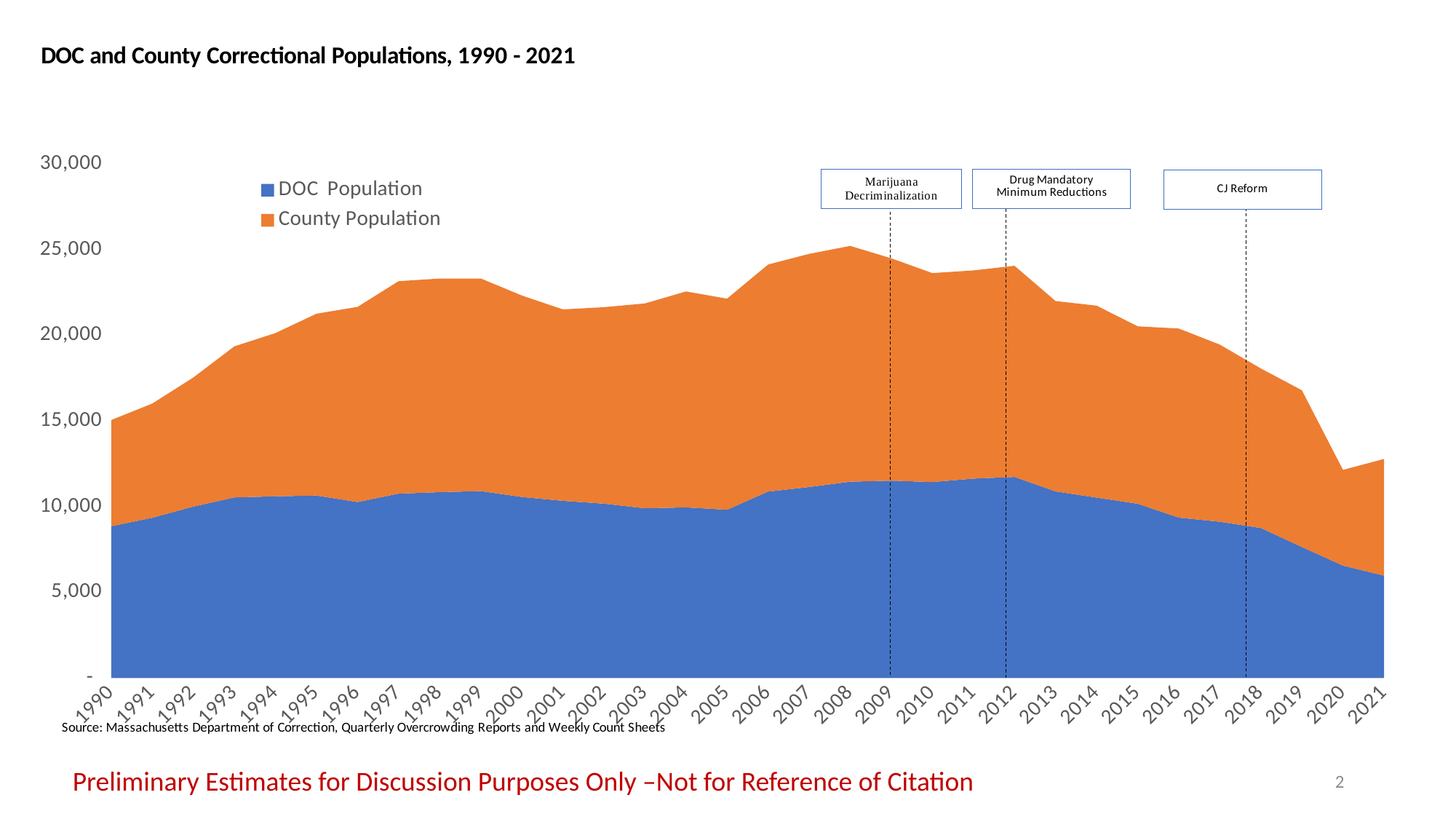
In which year is the DOC Population lowest? 2021 In which year is the combined DOC and County population highest? 2008 Is the combined DOC and County population in 2019 greater or less than 15,000? greater Is the DOC Population in 1990 greater or less than 10,000? less Which series is shown in orange? County Population How many series does the legend list? 2 Is the DOC Population in 2012 greater or less than 10,000? greater How many years are plotted along the x axis? 32 Does the DOC Population rise or fall from 2012 to 2021? fall What kind of chart is shown on the slide? Stacked area chart What is the title of the chart? DOC and County Correctional Populations, 1990 - 2021